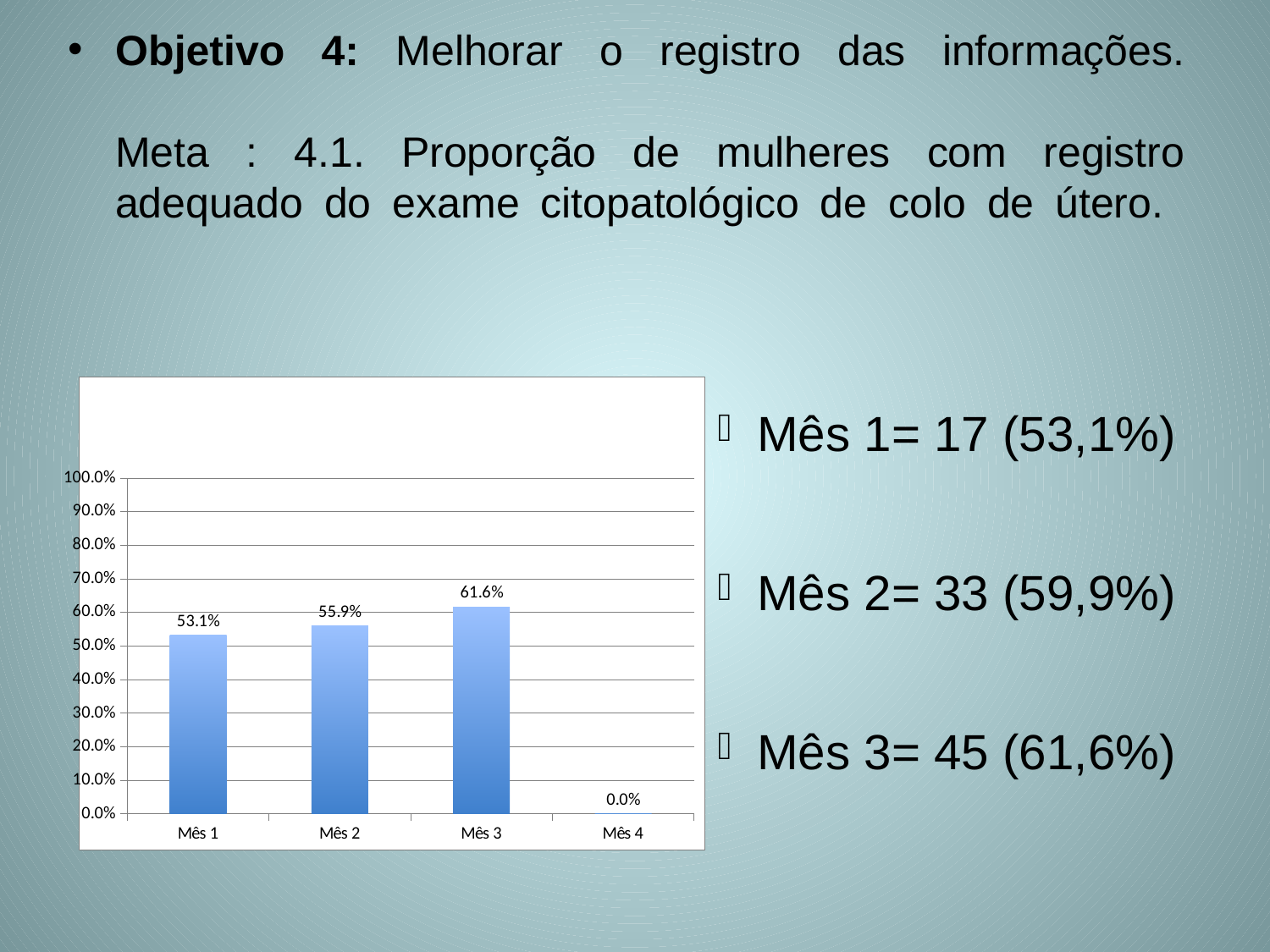
What kind of chart is shown on the slide? bar chart Is the value for Mês 3 greater or less than 60.0%? greater How many categories are shown on the x axis? 4 Do the values rise or fall from Mês 1 to Mês 3? rise What is the difference between the values for Mês 3 and Mês 1? 8.5% What is the value for Mês 4? 0.0% Which is larger, the value for Mês 2 or the value for Mês 1? Mês 2 Which category has the lowest value? Mês 4 Which category has the highest value? Mês 3 What is the value for Mês 2? 55.9% What is the value for Mês 1? 53.1% What is the value for Mês 3? 61.6%